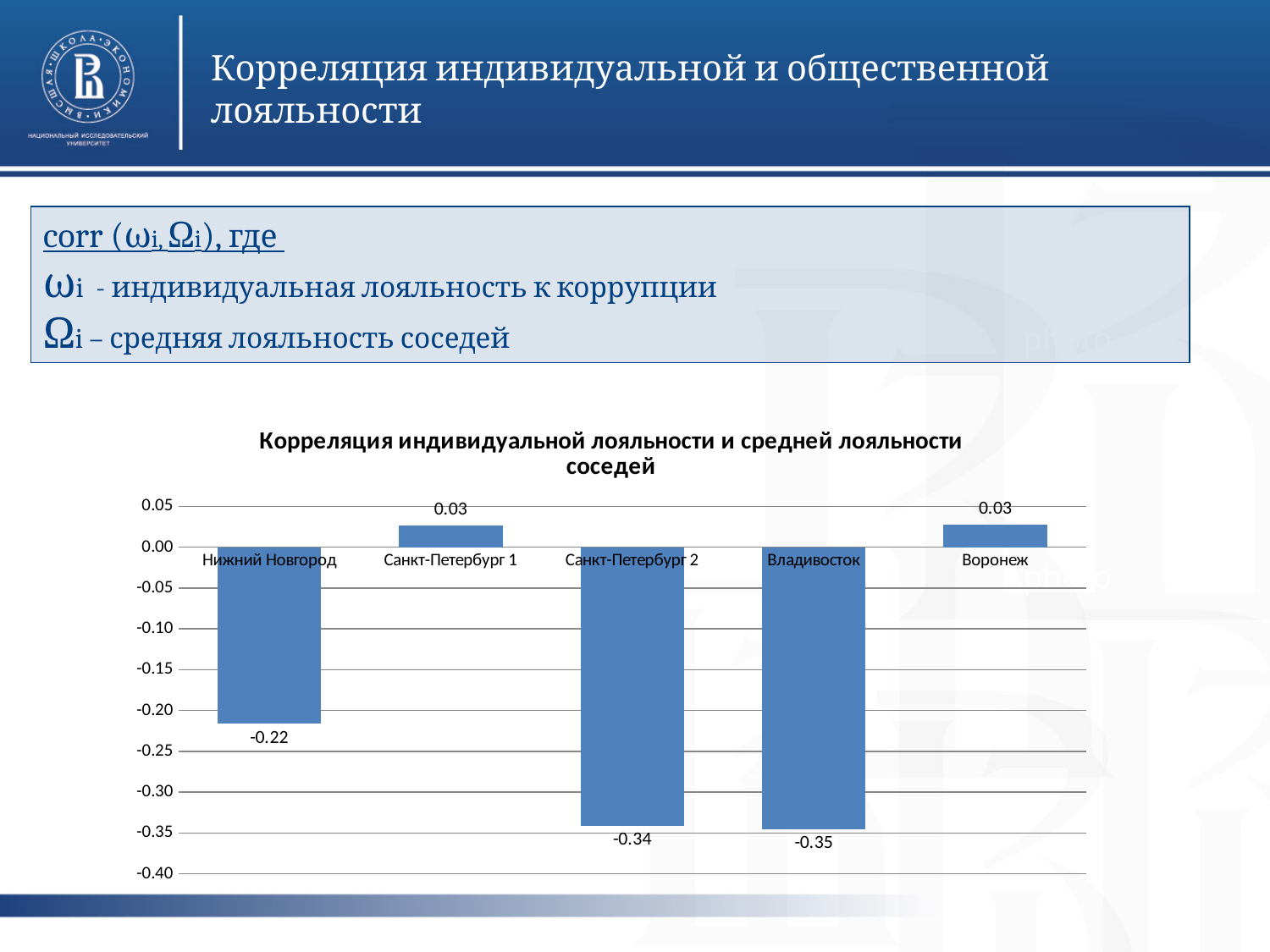
Which is larger, the value for Нижний Новгород or the value for Санкт-Петербург 2? Нижний Новгород Is the value for Нижний Новгород greater or less than -0.20? less What is the value for Владивосток? -0.35 How many categories have a negative value? 3 What is the value for Воронеж? 0.03 How many categories are shown on the chart? 5 What is the difference between the values for Санкт-Петербург 1 and Нижний Новгород? 0.25 Which category has the lowest value? Владивосток What is the value for Нижний Новгород? -0.22 What is the value for Санкт-Петербург 2? -0.34 What is the difference between the values for Санкт-Петербург 2 and Владивосток? 0.01 What kind of chart is shown on the slide? bar chart